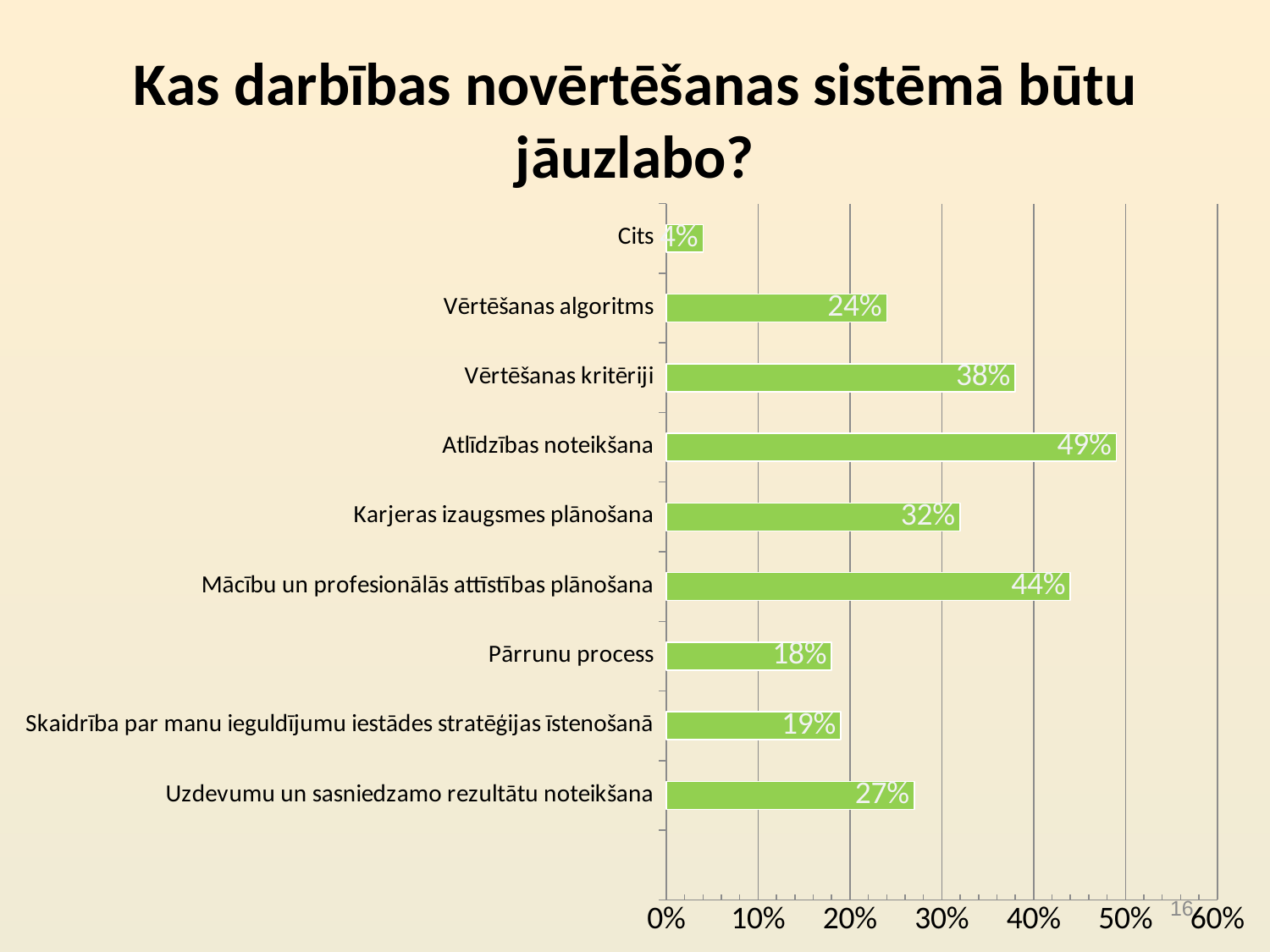
What is the value for Atlīdzības noteikšana? 49% Which is larger, the value for Vērtēšanas kritēriji or the value for Karjeras izaugsmes plānošana? Vērtēšanas kritēriji Which category has the highest value? Atlīdzības noteikšana What is the difference between the values for Atlīdzības noteikšana and Mācību un profesionālās attīstības plānošana? 5% What is the value for Uzdevumu un sasniedzamo rezultātu noteikšana? 27% Is the value for Vērtēšanas algoritms greater or less than 20%? greater What kind of chart is shown on the slide? bar chart Which category has the lowest value? Cits What is the value for Pārrunu process? 18% How many categories are shown in the chart? 9 What colour are the bars in the chart? green What is the title of the slide? Kas darbības novērtēšanas sistēmā būtu jāuzlabo?